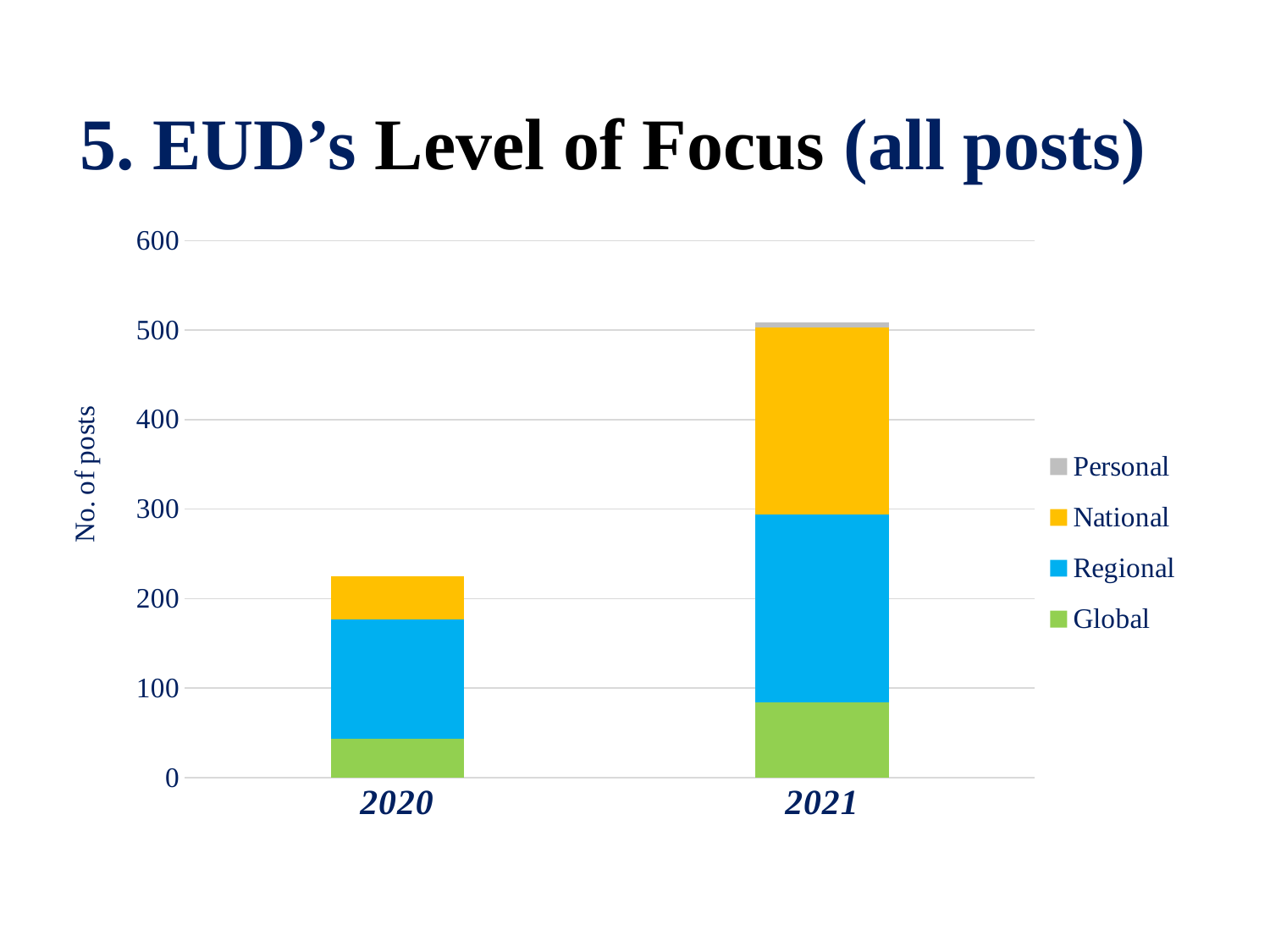
Is the total number of posts for 2021 greater or less than 400? greater Is the total number of posts for 2020 greater or less than 300? less Which series has the smallest segment in the 2021 bar? Personal Does the total number of posts rise or fall from 2020 to 2021? rise Is the Global segment for 2021 greater or less than 100? less What is the label on the chart's vertical axis? No. of posts Which series is shown in yellow in the chart's legend? National What kind of chart is shown on the slide? Stacked bar chart How many years are shown on the x axis of the chart? 2 Which year has the taller stacked bar, 2020 or 2021? 2021 Which series has the largest segment in the 2020 bar? Regional How many series does the chart's legend list? 4